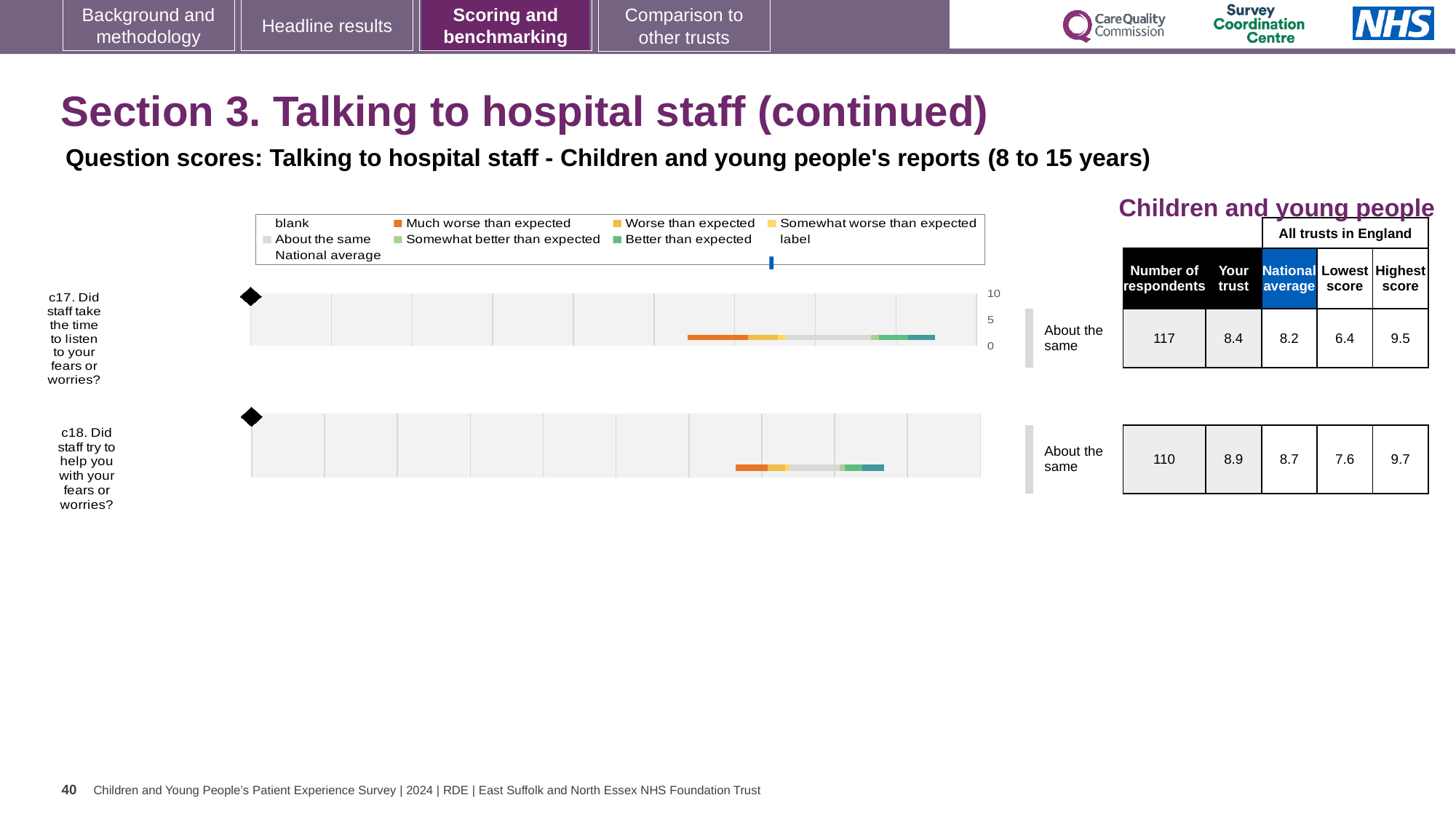
How many more respondents answered c17 than c18? 7 Which legend entry is shown in orange? Much worse than expected What is the lowest score among all trusts in England for c18? 7.6 What is the highest score among all trusts in England for c17? 9.5 What is the 'Your trust' score for c17 (Did staff take the time to listen to your fears or worries?)? 8.4 What benchmark label is given to the trust's result for c17? About the same What kind of chart is used to show the question scores for c17 and c18? bar chart What is the national average score for c18 (Did staff try to help you with your fears or worries?)? 8.7 Which question has the higher 'Your trust' score, c17 or c18? c18 What is the difference between the 'Your trust' score and the national average for c18? 0.2 How many respondents answered c17? 117 How many questions (categories) are plotted in the chart? 2